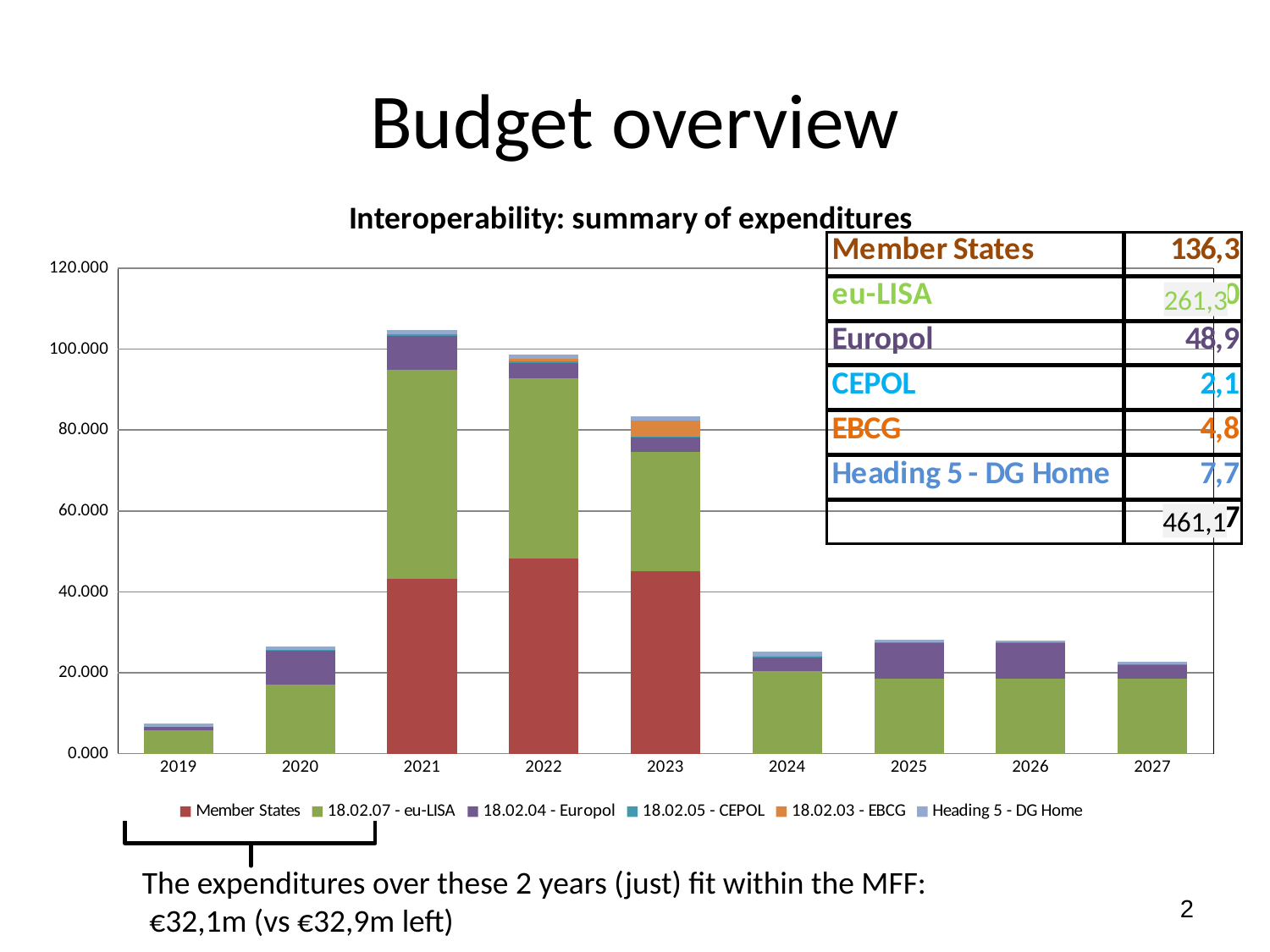
How many years are shown on the x axis of the chart? 9 Is the total value for 2021 greater or less than 100.000? greater Is the total value for 2019 greater or less than 20.000? less Is the total value for 2023 greater or less than 60.000? greater Which year has the larger total expenditure, 2023 or 2024? 2023 How many series does the chart legend list? 6 Which series is shown in red in the chart? Member States What type of chart is shown on the slide? Stacked bar chart Which year has the lowest total expenditure in the chart? 2019 Which year has the highest total expenditure in the chart? 2021 Do the total values rise or fall from 2019 to 2021? rise What is the title of the chart? Interoperability: summary of expenditures